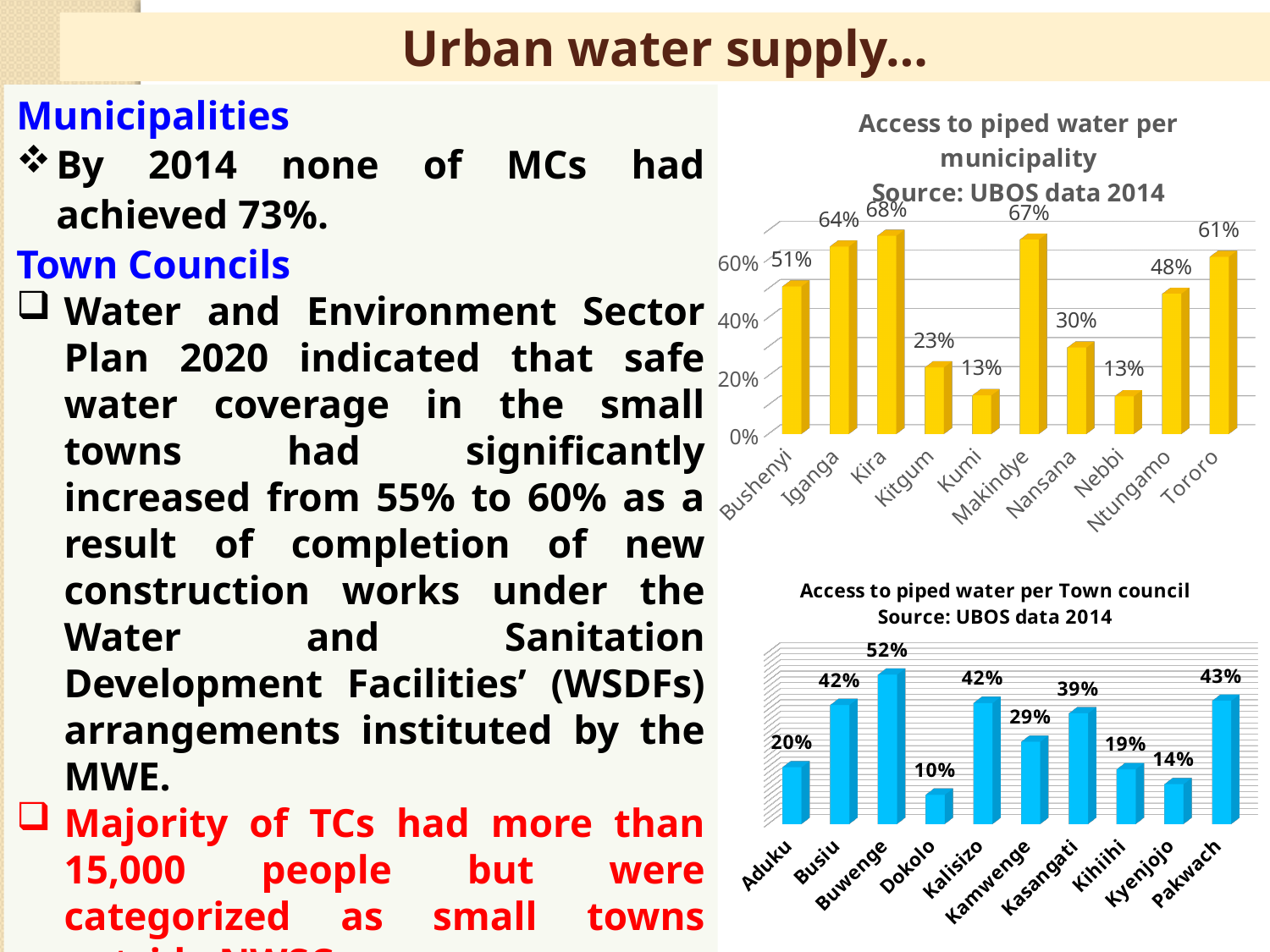
In the 'Access to piped water per municipality' chart, what is the value for Nansana? 30% What kind of chart is the 'Access to piped water per Town council' chart? Bar chart What data source is cited in the title of the 'Access to piped water per municipality' chart? UBOS data 2014 In the 'Access to piped water per municipality' chart, what is the value for Bushenyi? 51% In the 'Access to piped water per Town council' chart, which town council has the lowest value? Dokolo In the 'Access to piped water per municipality' chart, which is larger, Iganga or Kitgum? Iganga In the 'Access to piped water per Town council' chart, what is the value for Kasangati? 39% In the 'Access to piped water per municipality' chart, what is the difference between Tororo and Ntungamo? 13% In the 'Access to piped water per municipality' chart, is the value for Kumi greater or less than 20%? less In the 'Access to piped water per Town council' chart, which town council has the highest value? Buwenge In the 'Access to piped water per municipality' chart, how many municipalities are shown? 10 In the 'Access to piped water per Town council' chart, what is the difference between Pakwach and Kihiihi? 24%